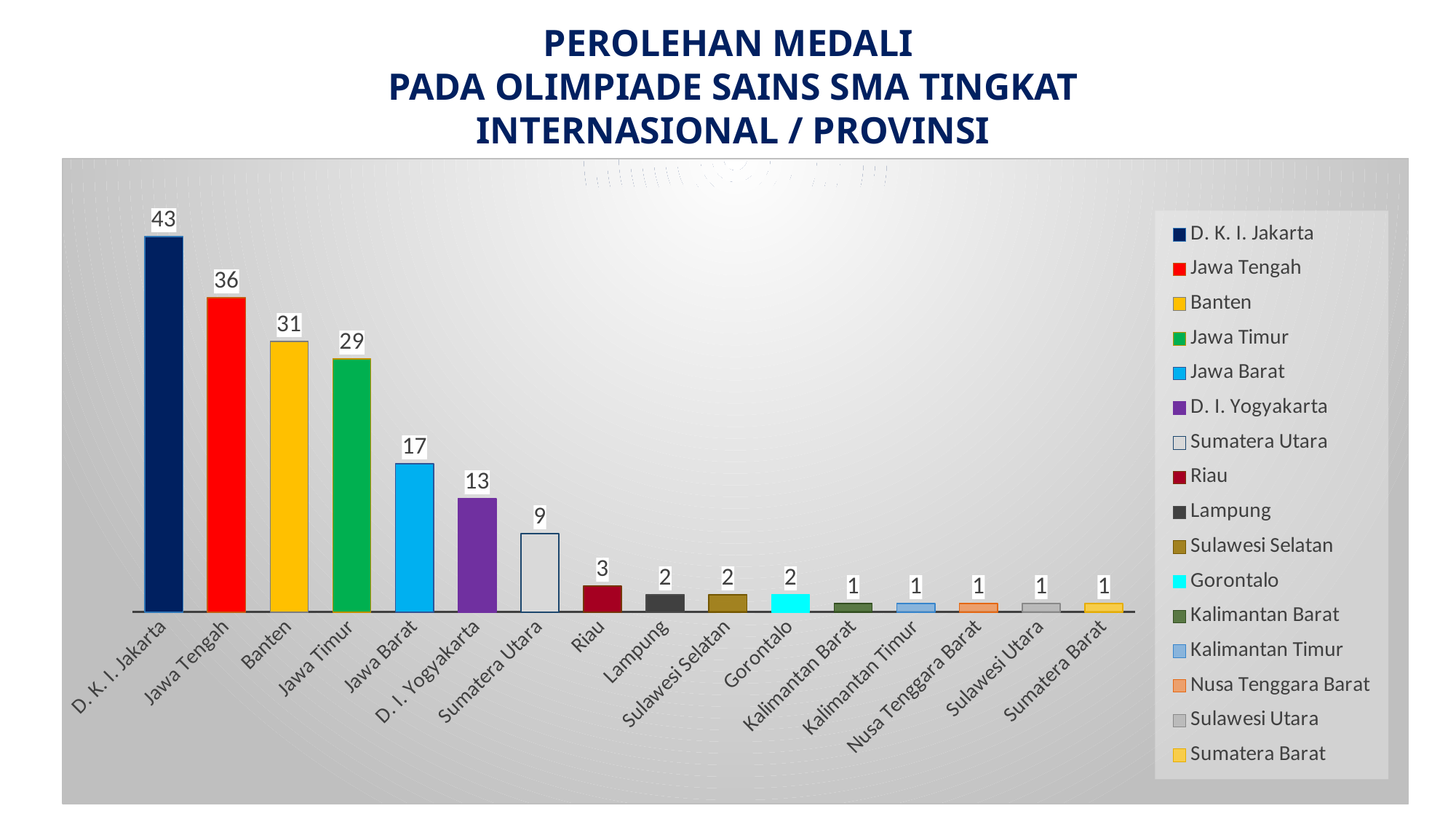
Do the values rise or fall moving from left to right along the x axis? Fall What is the difference between the values for D. K. I. Jakarta and Jawa Timur? 14 What is the value shown for Sumatera Utara? 9 What kind of chart is shown on the slide? Bar chart How many medals did D. K. I. Jakarta obtain according to the chart? 43 Which has a larger value, D. I. Yogyakarta or Riau? D. I. Yogyakarta What is the difference between the values for Jawa Tengah and Banten? 5 Which has a larger value, Jawa Timur or Jawa Barat? Jawa Timur How many provinces are shown on the x axis of the chart? 16 What is the value shown for Jawa Barat? 17 How many entries does the legend list? 16 Which province has the highest medal count on the chart? D. K. I. Jakarta